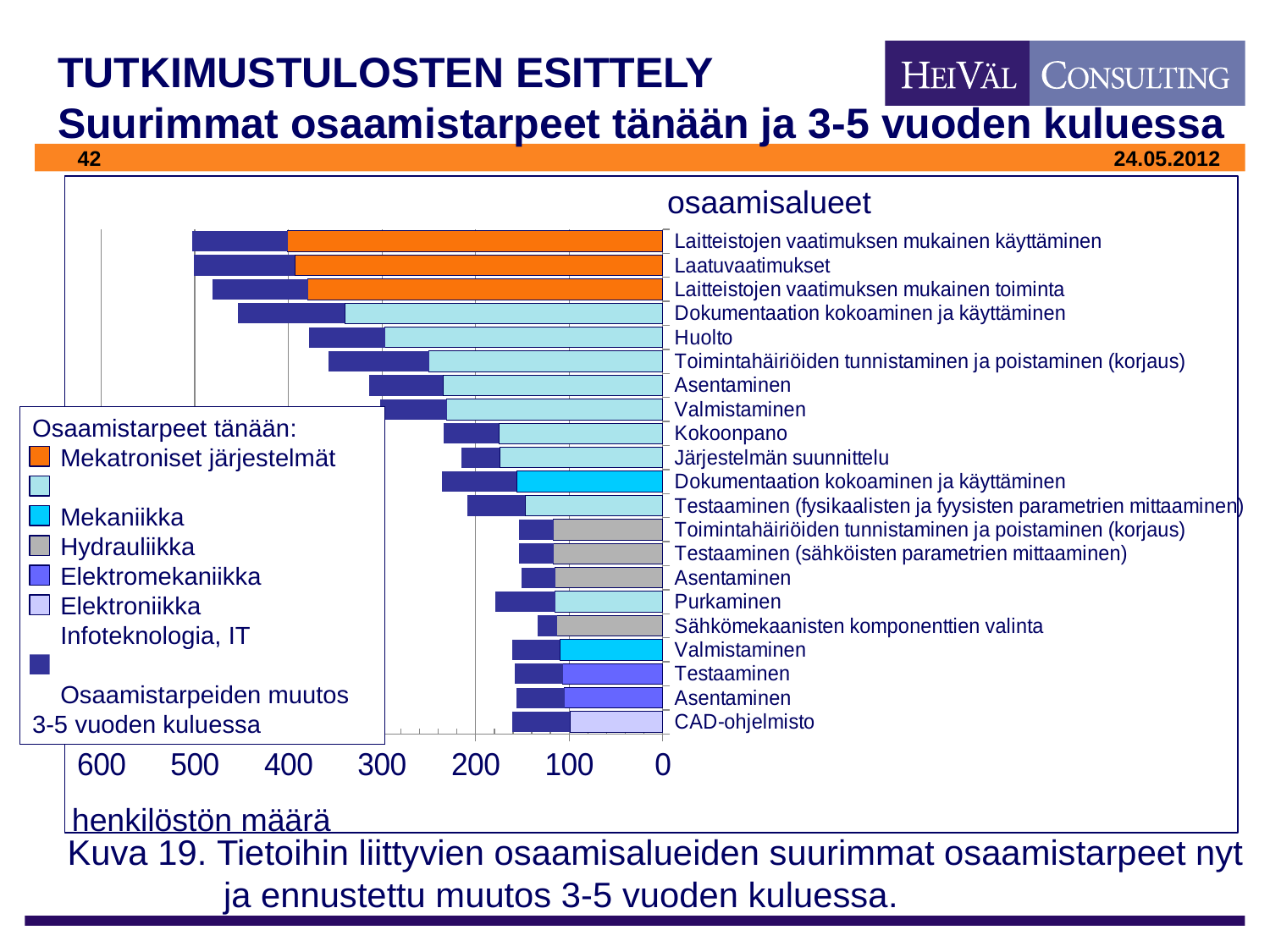
Is the total bar for Huolto greater or less than 300? greater Is the total bar for Kokoonpano greater or less than 300? less What kind of chart is shown on the slide? bar chart Is the total bar for Purkaminen greater or less than 300? less Which has the longer total bar, Huolto or Purkaminen? Huolto Which category has the shortest total bar in the chart? Sähkömekaanisten komponenttien valinta How many osaamisalue categories are plotted in the chart? 21 Which colour represents Mekatroniset järjestelmät in the legend? orange What is the label of the horizontal axis of the chart? henkilöstön määrä Which has the longer total bar, Laatuvaatimukset or Kokoonpano? Laatuvaatimukset